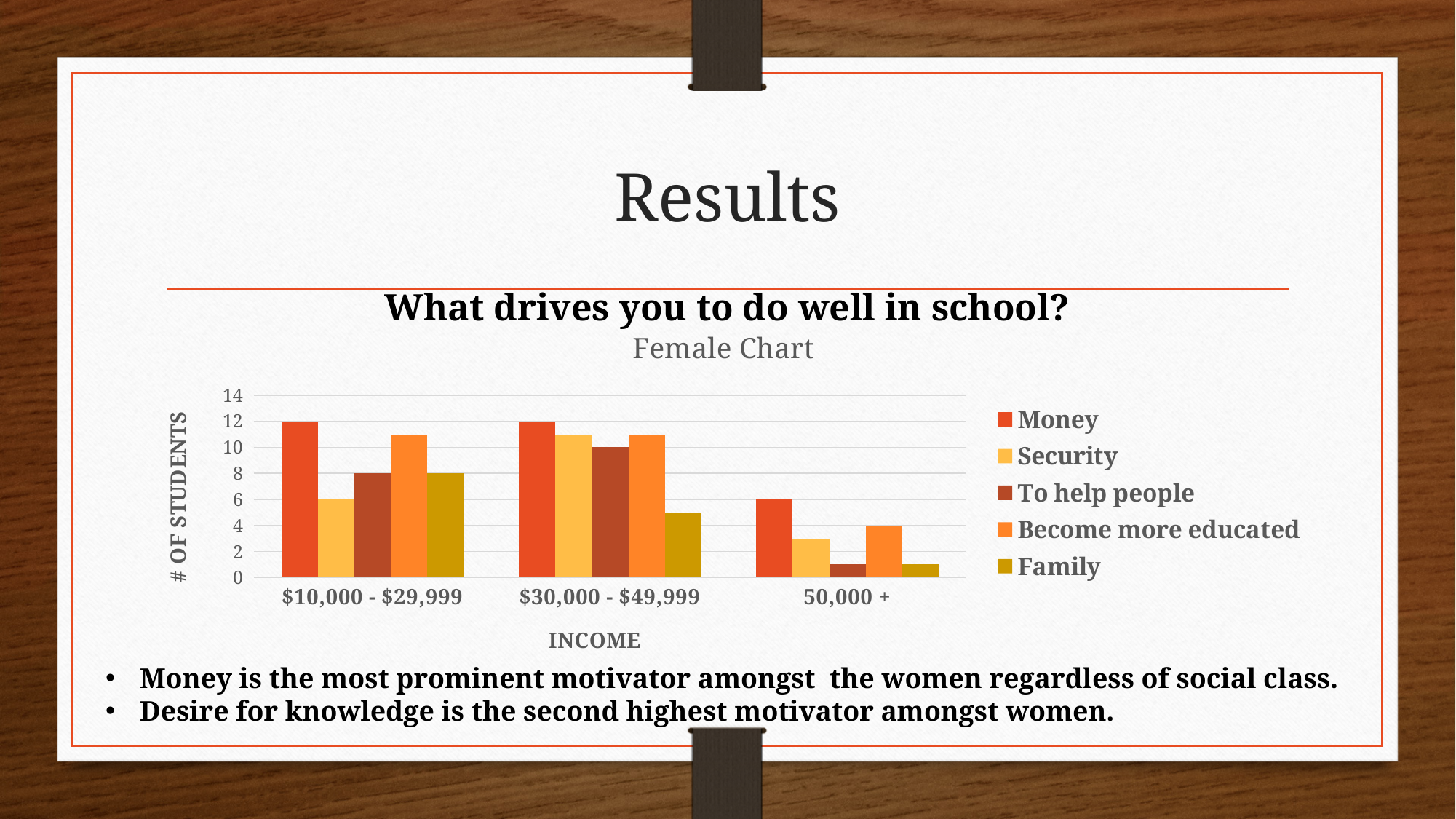
What kind of chart is shown on the slide? bar chart Is the value for Security in the 50,000 + income group greater or less than 4? less How many income categories are shown on the x axis? 3 Which motivator has the lowest value in the $30,000 - $49,999 income group? Family What is the value for Security in the $10,000 - $29,999 income group? 6 What is the value for Money in the 50,000 + income group? 6 Which motivator has the highest value in the 50,000 + income group? Money What is the value for To help people in the $30,000 - $49,999 income group? 10 What is the value for Money in the $10,000 - $29,999 income group? 12 What is the difference between the Money and Security values in the $10,000 - $29,999 income group? 6 How many series does the legend list? 5 Is the value for Become more educated in the $10,000 - $29,999 income group greater or less than 10? greater